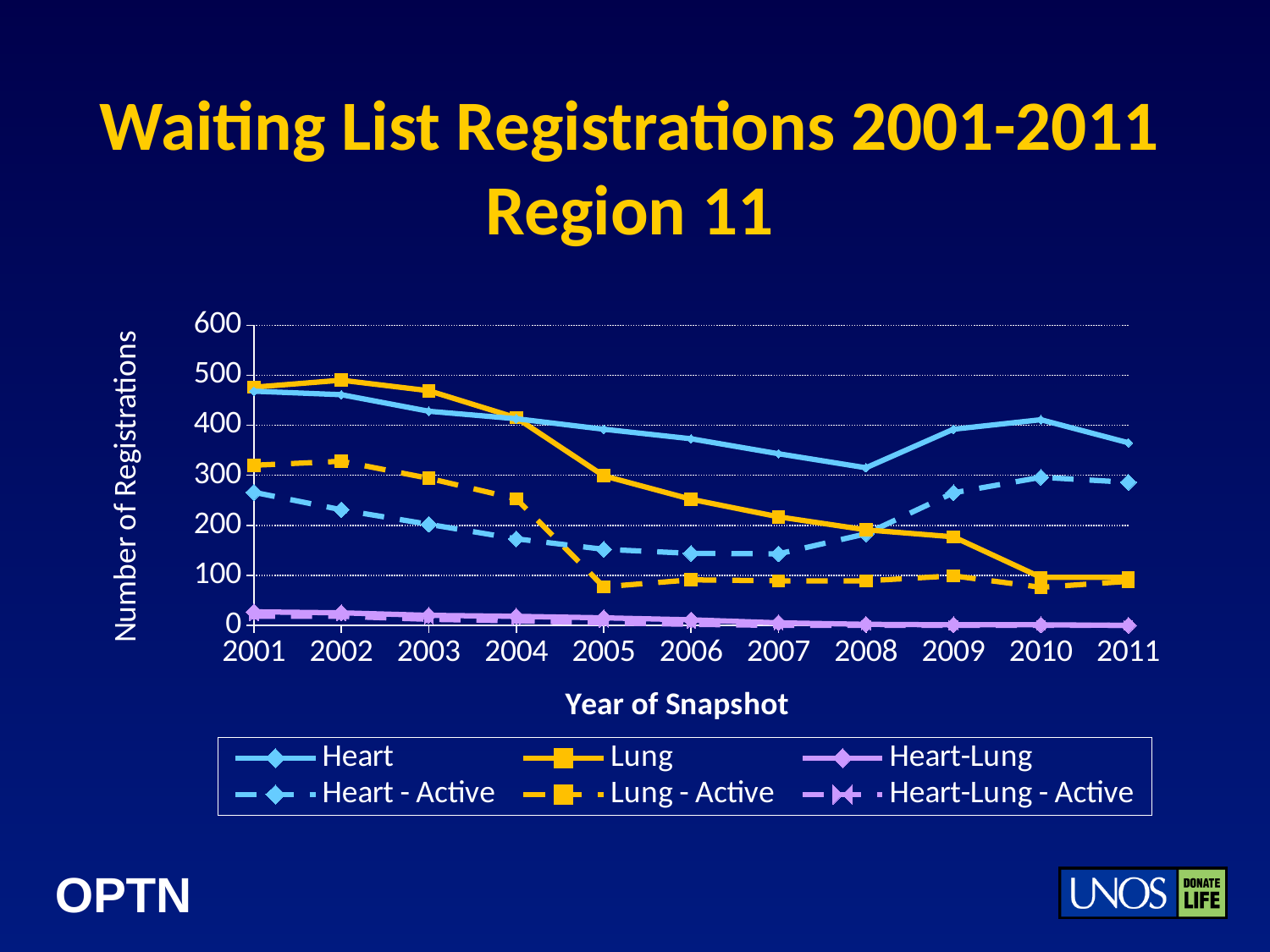
Is the value for Lung in 2002 greater or less than 400? greater Which series has the highest value in 2011? Heart What kind of chart is shown on the slide? line chart Is the value for Heart - Active in 2005 greater or less than 200? less Does the Lung series rise or fall from 2001 to 2011? fall In 2011, which is larger: Heart or Lung? Heart What is the label of the y axis? Number of Registrations Is the value for Lung in 2010 greater or less than 200? less How many series does the legend list? 6 How many years are plotted along the x axis? 11